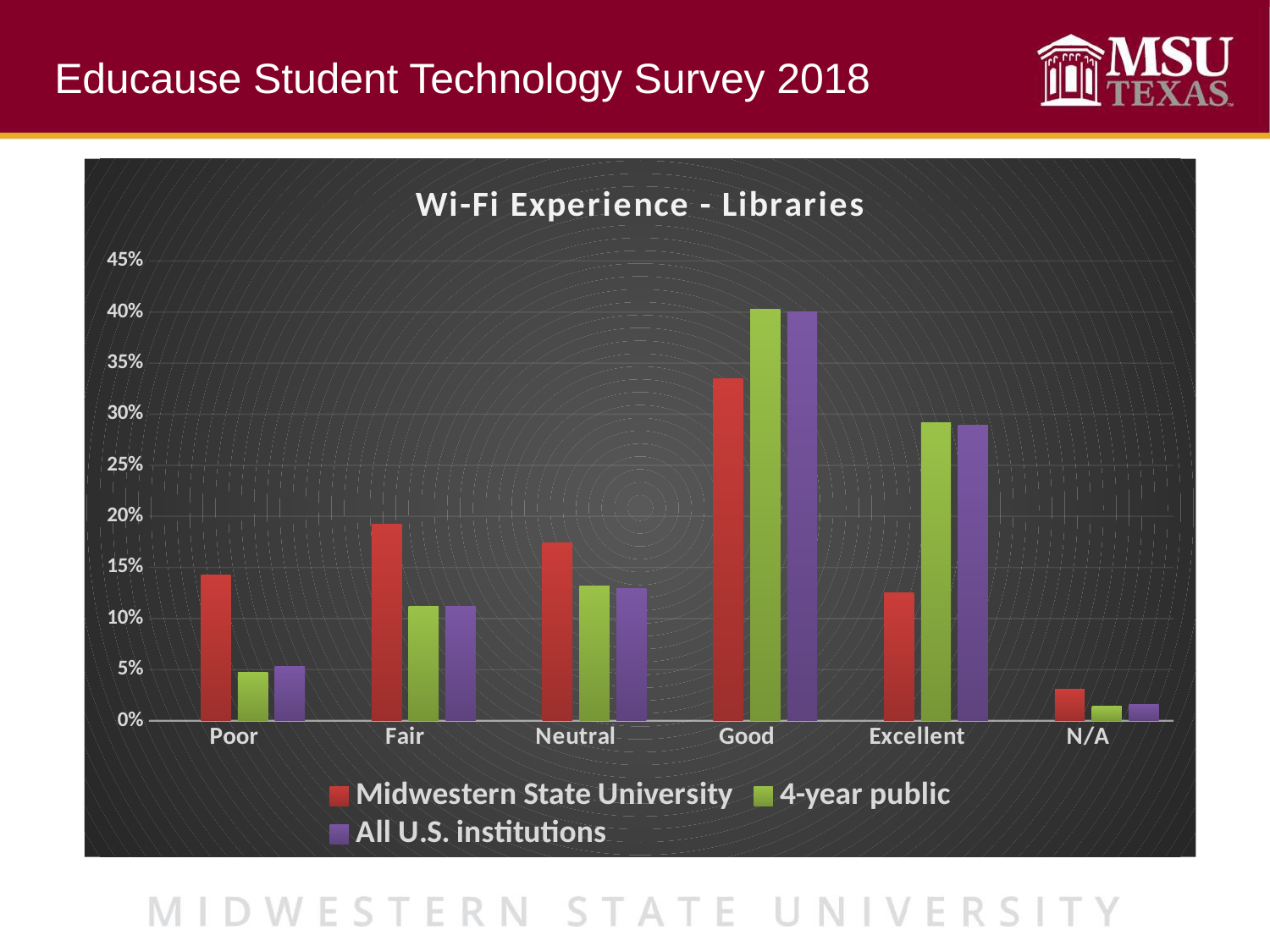
Is the value for Midwestern State University in the Good category greater or less than 35%? less In the Poor category, which is larger: Midwestern State University or All U.S. institutions? Midwestern State University In the Excellent category, which is larger: Midwestern State University or 4-year public? 4-year public How many series does the legend list? 3 What is the title of the chart? Wi-Fi Experience - Libraries What colour represents the Midwestern State University series? red How many categories are shown on the x axis? 6 Is the value for 4-year public in the Good category greater or less than 35%? greater What kind of chart is shown on the slide? bar chart Which category has the lowest value for Midwestern State University? N/A Is the value for Midwestern State University in the Fair category greater or less than 15%? greater Which category has the highest value for Midwestern State University? Good